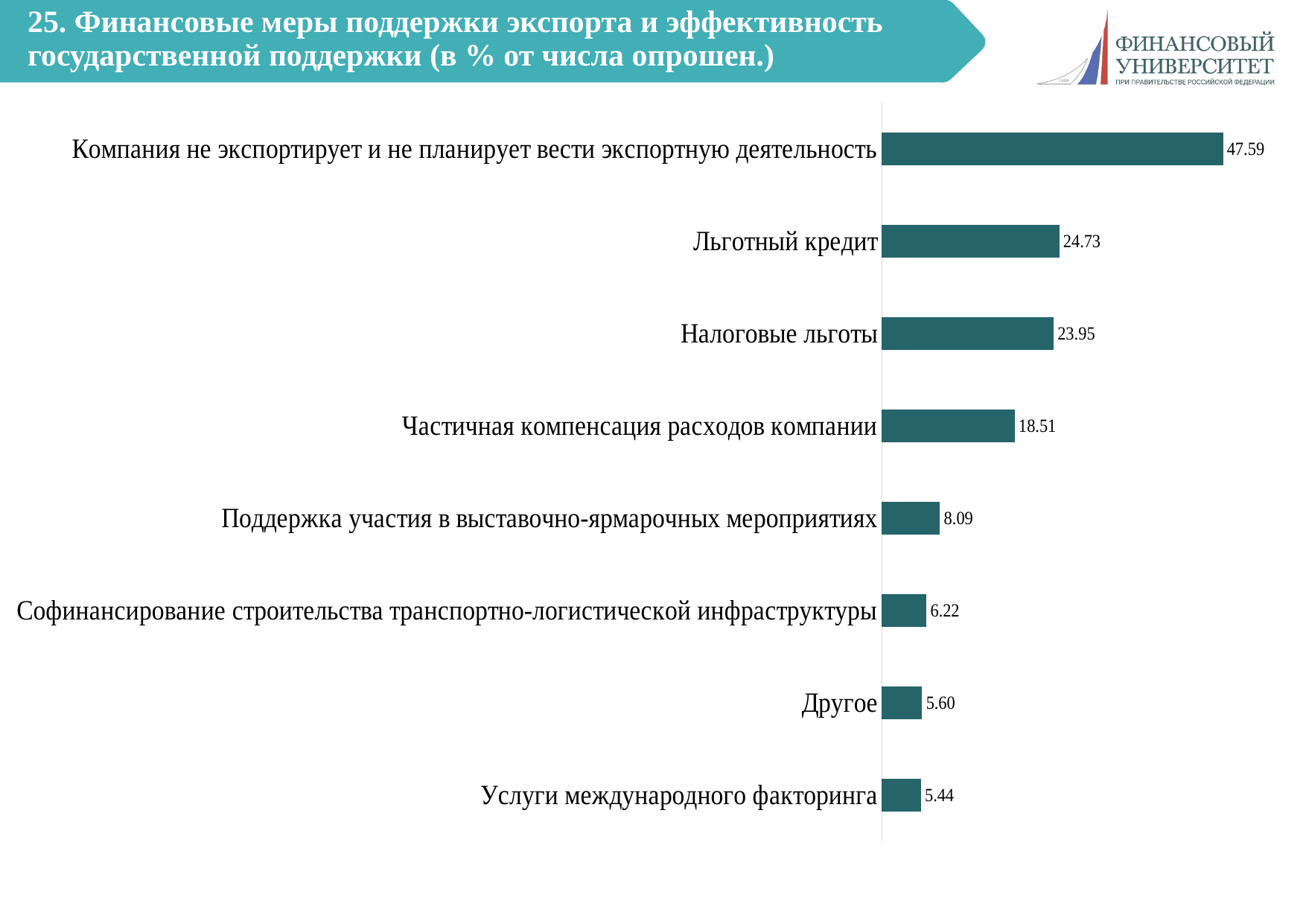
Which category has the lowest value? Услуги международного факторинга What is the difference between the values for «Льготный кредит» and «Налоговые льготы»? 0.78 What is the value for «Софинансирование строительства транспортно-логистической инфраструктуры»? 6.22 Which is larger: the value for «Поддержка участия в выставочно-ярмарочных мероприятиях» or for «Другое»? Поддержка участия в выставочно-ярмарочных мероприятиях What is the difference between the values for «Компания не экспортирует и не планирует вести экспортную деятельность» and «Льготный кредит»? 22.86 What is the value for «Льготный кредит»? 24.73 How many categories are shown in the chart? 8 Which category has the highest value? Компания не экспортирует и не планирует вести экспортную деятельность What is the value for «Частичная компенсация расходов компании»? 18.51 What kind of chart is shown on the slide? Bar chart What is the value for «Налоговые льготы»? 23.95 What is the value for «Услуги международного факторинга»? 5.44